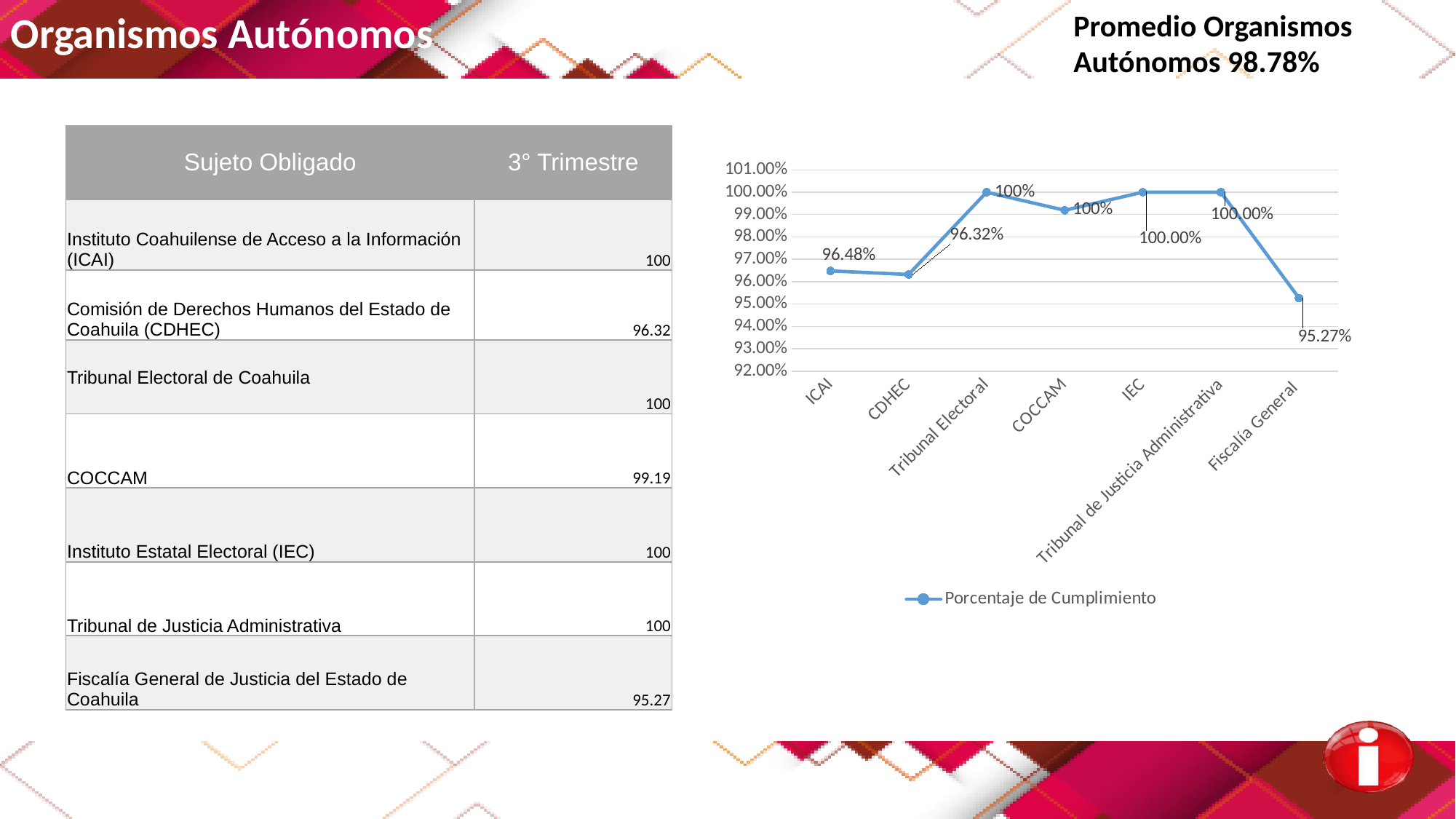
Which has the larger value in the chart, ICAI or CDHEC? ICAI Which category has the lowest value in the chart? Fiscalía General What kind of chart is shown on the slide? Line chart How many categories are plotted along the x axis of the chart? 7 What is the difference between the values for ICAI and Fiscalía General in the chart? 1.21% What is the value plotted for IEC in the chart? 100.00% What series name is shown in the chart legend? Porcentaje de Cumplimiento What is the value plotted for CDHEC in the chart? 96.32% What is the value plotted for Fiscalía General in the chart? 95.27% Is the value for COCCAM in the chart greater or less than 98.00%? greater What is the value plotted for ICAI in the chart? 96.48% How many series does the chart legend list? 1